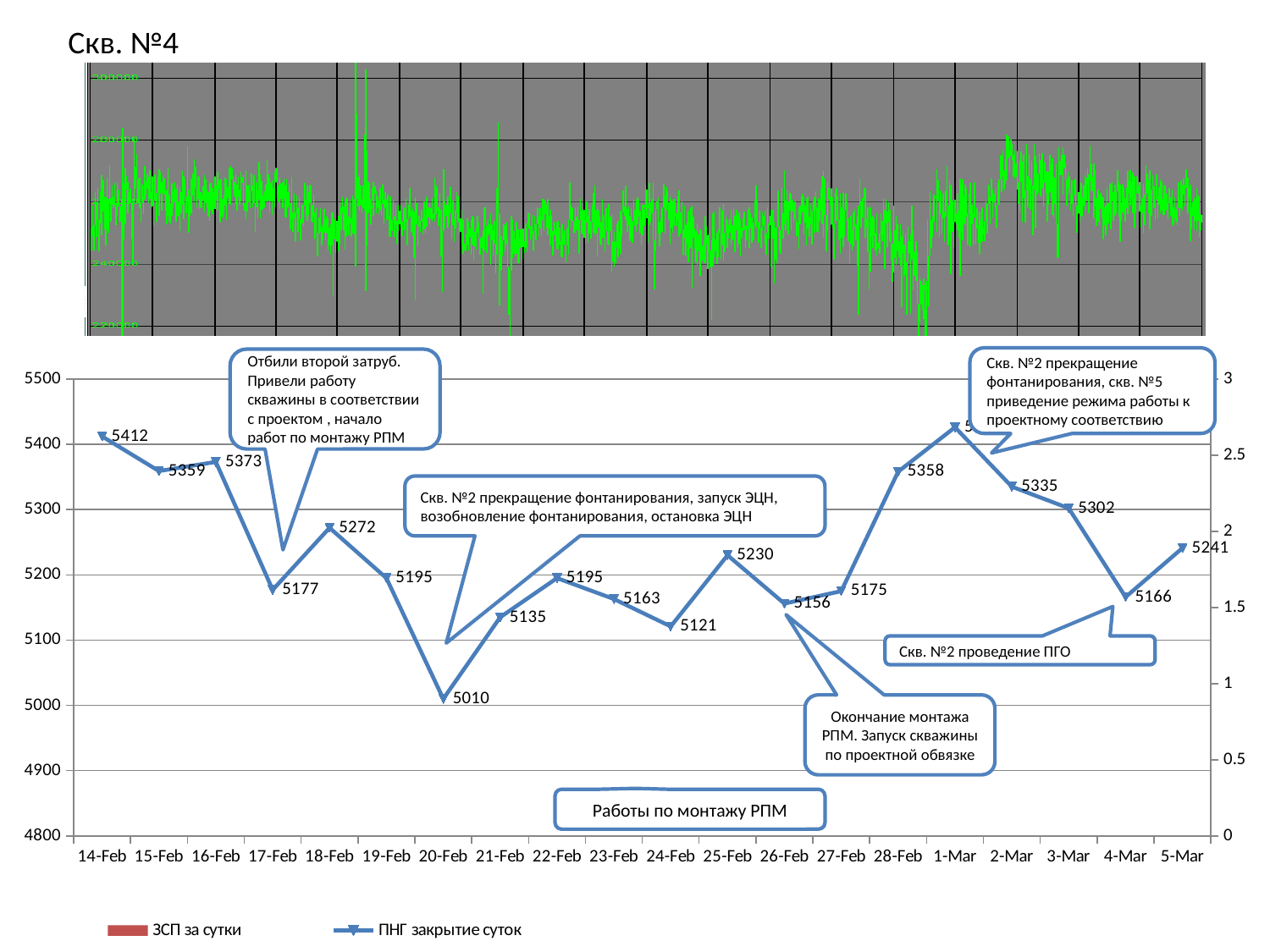
How many series does the legend of the line chart list? 2 How many dates are shown on the x axis of the line chart? 20 Is the ПНГ закрытие суток value on 1-Mar greater or less than 5400? greater What type of chart is the lower chart on the slide? line chart What is the difference between the ПНГ закрытие суток values on 14-Feb and 15-Feb? 53 Do the ПНГ закрытие суток values rise or fall from 2-Mar to 4-Mar? fall On which date is the ПНГ закрытие суток value lowest? 20-Feb Which date has the larger ПНГ закрытие суток value, 18-Feb or 19-Feb? 18-Feb What is the value of ПНГ закрытие суток on 20-Feb? 5010 What is the value of ПНГ закрытие суток on 14-Feb? 5412 What is the difference between the ПНГ закрытие суток values on 28-Feb and 27-Feb? 183 What is the value of ПНГ закрытие суток on 5-Mar? 5241